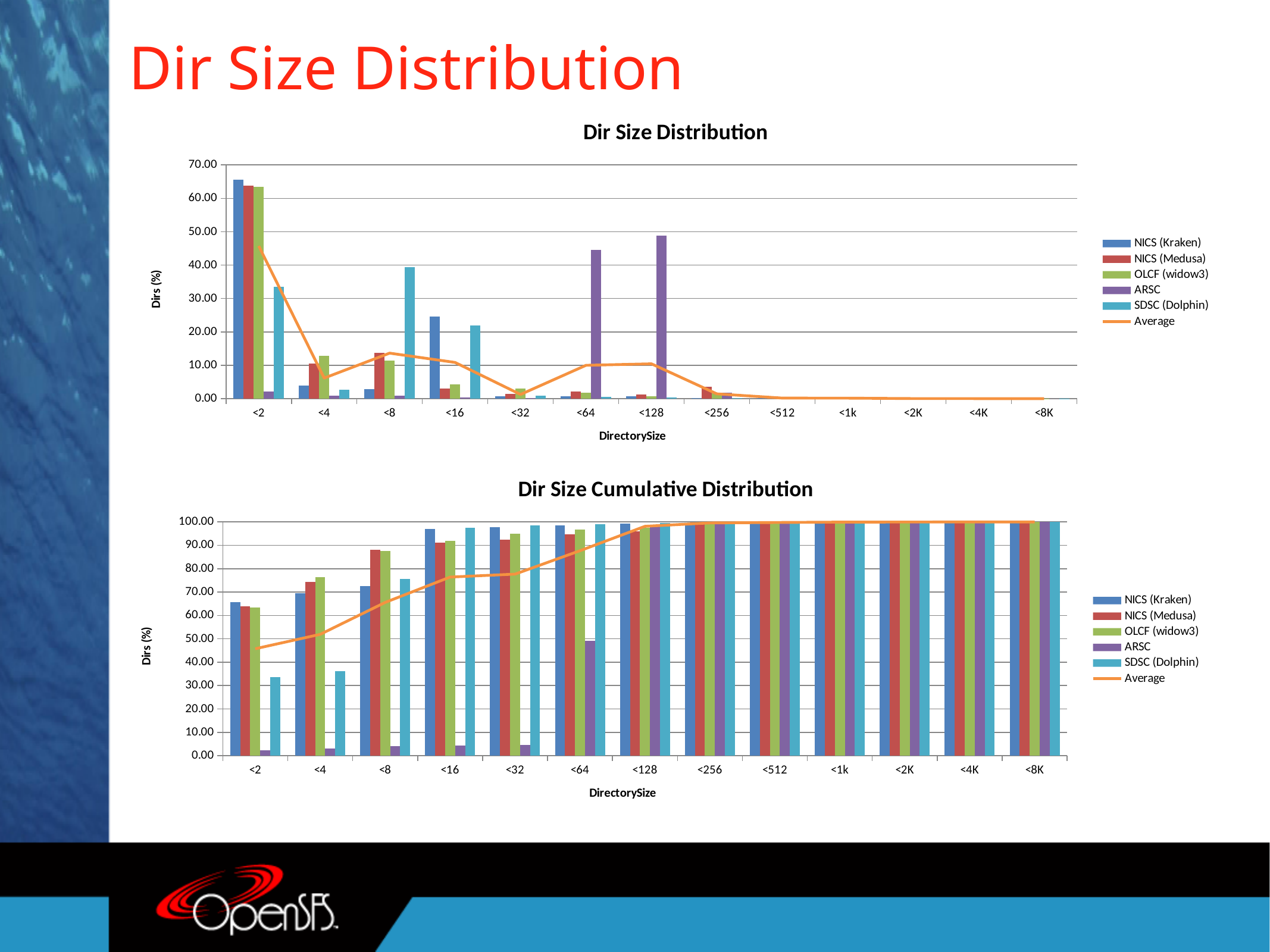
In the top chart, Dir Size Distribution, how many directory size categories are shown on the x axis? 13 In the bottom chart, Dir Size Cumulative Distribution, does the Average line rise or fall as directory size increases along the x axis? rises In the bottom chart, Dir Size Cumulative Distribution, which is larger at <4: OLCF (widow3) or SDSC (Dolphin)? OLCF (widow3) In the bottom chart, Dir Size Cumulative Distribution, is the value for SDSC (Dolphin) at <2 greater or less than 30.00? greater In the top chart, Dir Size Distribution, is the value for ARSC at <64 greater or less than 40.00? greater In the top chart, Dir Size Distribution, is the value for NICS (Kraken) at <2 greater or less than 60.00? greater In the top chart, Dir Size Distribution, how many series does the legend list? 6 What kind of chart is the bottom chart, Dir Size Cumulative Distribution? combination bar and line chart In the top chart, Dir Size Distribution, which series has the highest bar at the <2 category? NICS (Kraken) In the top chart, Dir Size Distribution, which series has the highest bar at the <8 category? SDSC (Dolphin) In the top chart, Dir Size Distribution, at which category is the ARSC bar highest? <128 In the top chart, Dir Size Distribution, which is larger at <2: NICS (Kraken) or SDSC (Dolphin)? NICS (Kraken)